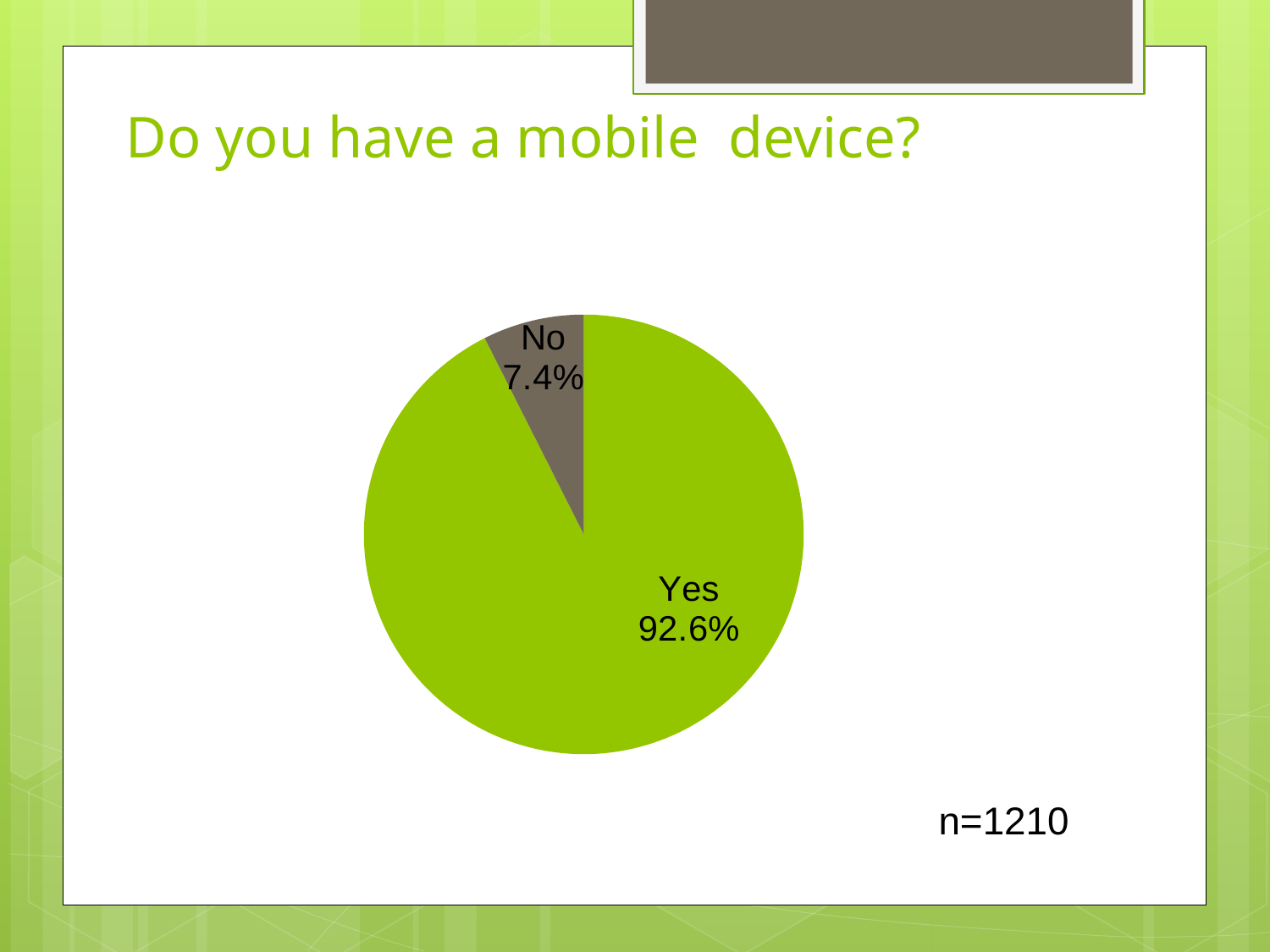
What sample size (n) is shown on the slide? n=1210 What kind of chart is shown on the slide? Pie chart Which response has the smallest share of the pie? No Which slice is larger, Yes or No? Yes What is the title of the slide containing the chart? Do you have a mobile device? Which response has the largest share of the pie? Yes What percentage of respondents answered No? 7.4% How many slices does the pie chart have? 2 What percentage of respondents answered Yes? 92.6% What is the difference in percentage points between the Yes and No slices? 85.2 What share of the pie does the No slice represent? 7.4%